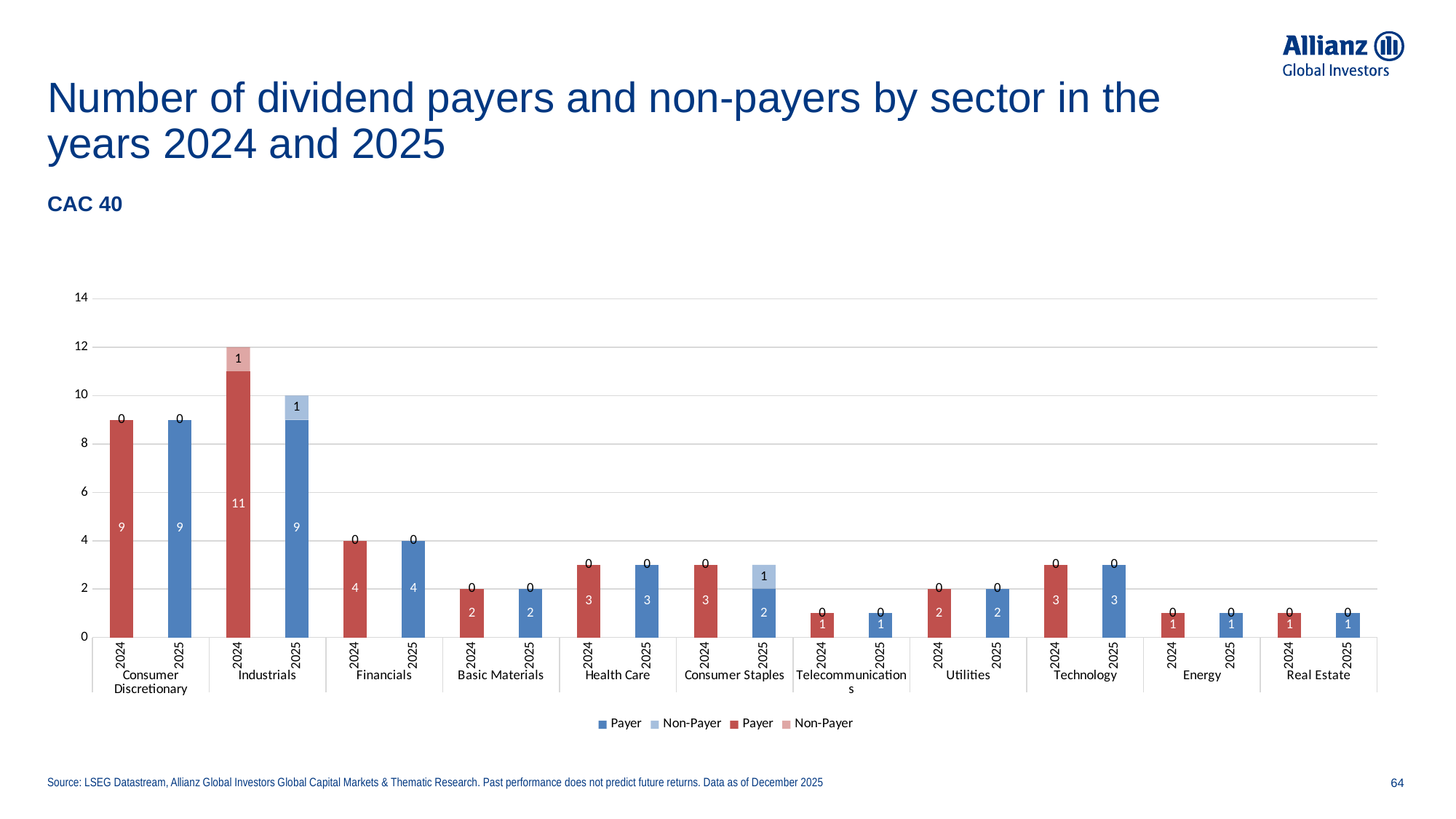
How many dividend payers did the Financials sector have in 2025? 4 How many entries does the chart legend list? 4 What is the total height of the stacked bar for Industrials in 2024 (payers plus non-payers)? 12 Which sector had the highest number of dividend payers in 2024? Industrials How many dividend payers did the Industrials sector have in 2024? 11 How many sectors are shown on the x axis of the chart? 11 What is the difference between the number of dividend payers in Industrials in 2024 and in 2025? 2 How many dividend payers did the Industrials sector have in 2025? 9 What is the total height of the stacked bar for Industrials in 2025 (payers plus non-payers)? 10 Which is larger: the number of dividend payers in Consumer Discretionary in 2024 or in Financials in 2024? Consumer Discretionary in 2024 What type of chart is shown on the slide? Stacked bar chart How many non-payers did the Consumer Staples sector have in 2025? 1